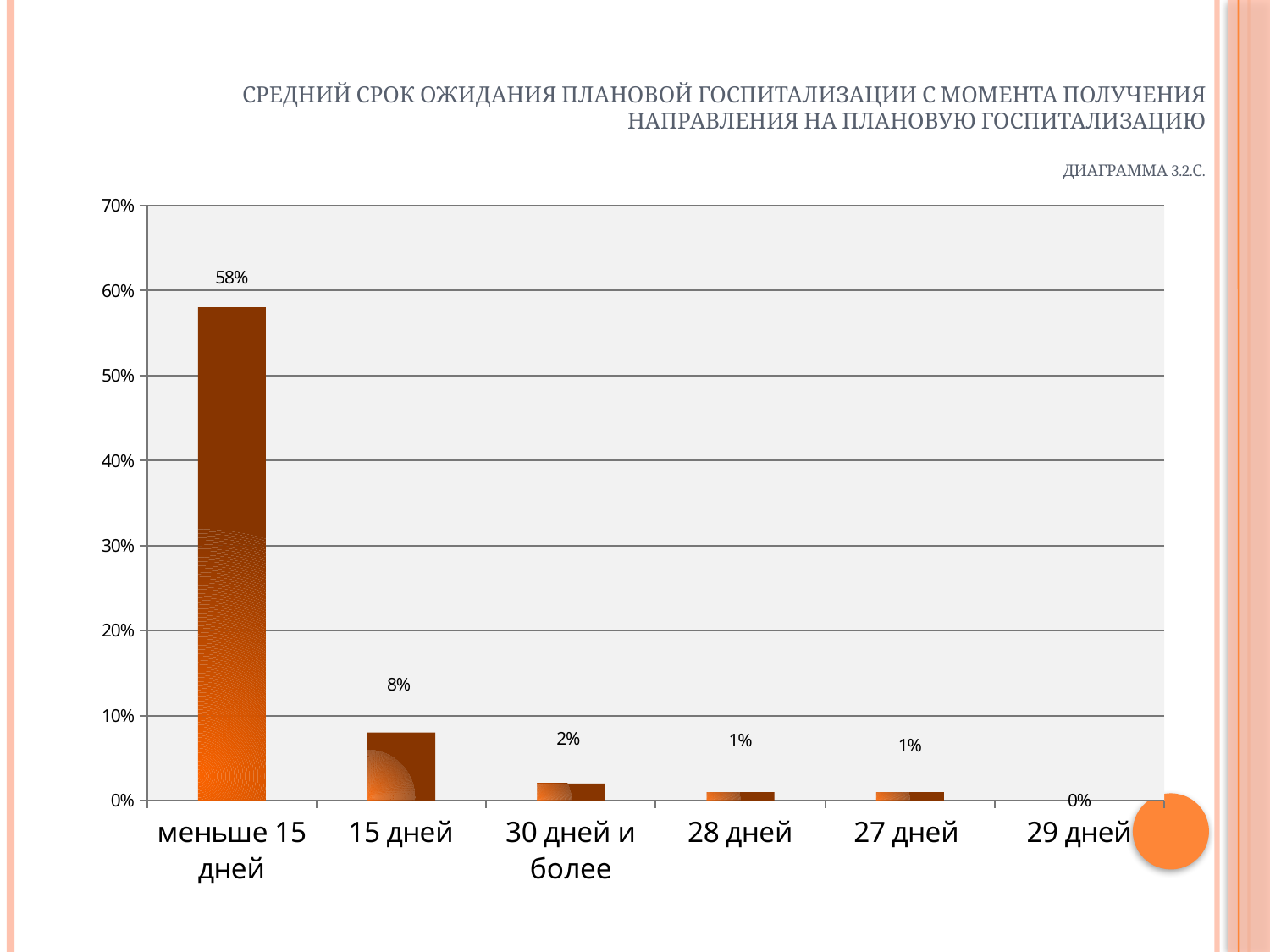
What is the value for "меньше 15 дней"? 58% What kind of chart is shown on the slide? bar chart Which is larger, the value for "15 дней" or the value for "30 дней и более"? 15 дней What is the difference between the values for "меньше 15 дней" and "15 дней"? 50% What is the value for "30 дней и более"? 2% Which category has the highest value? меньше 15 дней Is the value for "меньше 15 дней" greater or less than 50%? greater What is the highest value shown on the y axis? 70% How many categories are shown on the x axis? 6 What is the value for "29 дней"? 0% Which category has the lowest value? 29 дней What is the value for "15 дней"? 8%